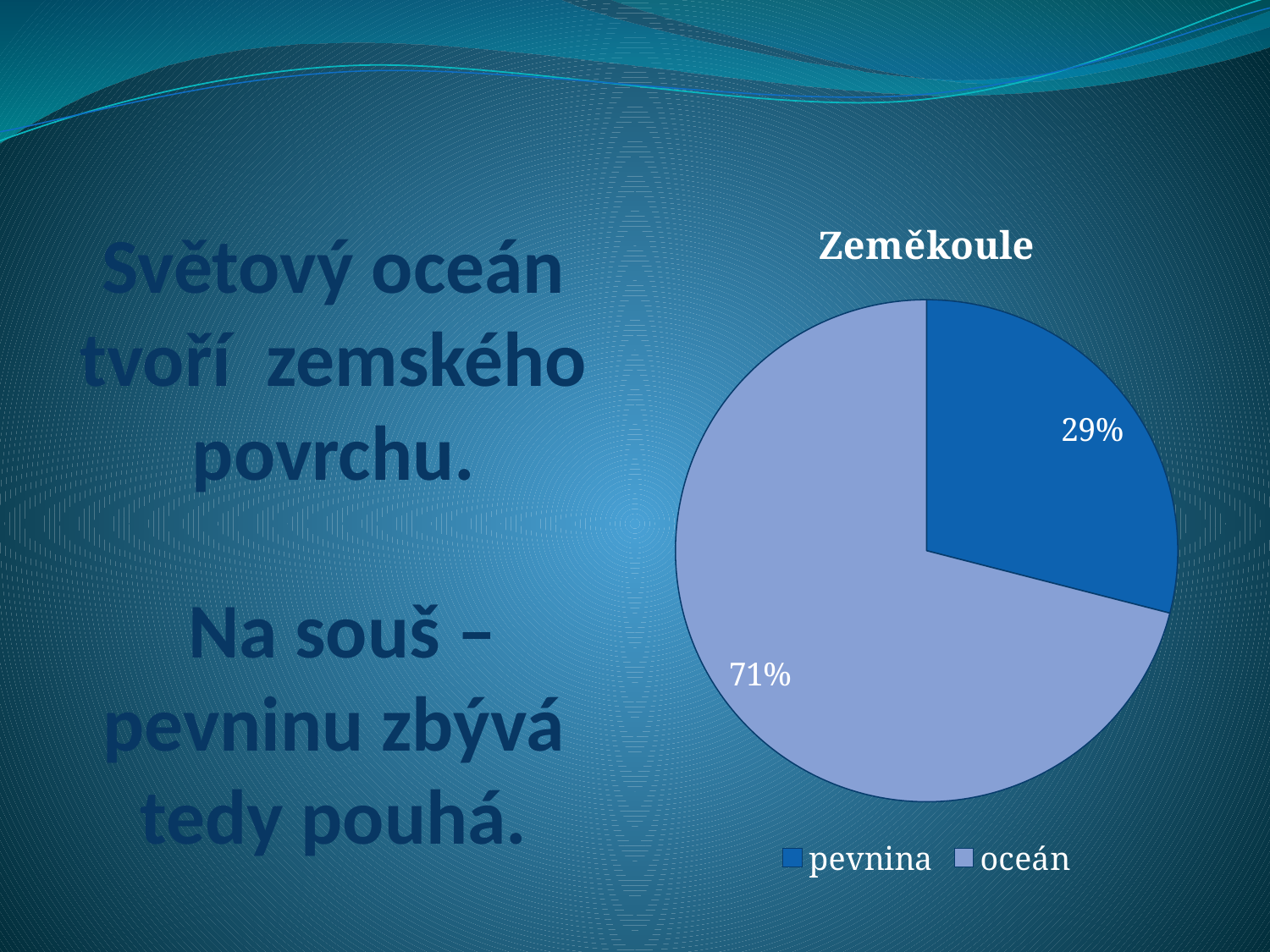
What is the difference in percentage points between the oceán and pevnina slices? 42 How many slices does the pie chart have? 2 What is the title of the chart? Zeměkoule What share of the pie does the pevnina slice represent? 29% What share of the pie does the oceán slice represent? 71% How many entries does the legend list? 2 Which legend entry is shown in the lighter blue colour? oceán Which is larger, the pevnina slice or the oceán slice? oceán Which slice is the largest in the pie chart? oceán What kind of chart is shown on the slide? pie chart Which slice is the smallest in the pie chart? pevnina